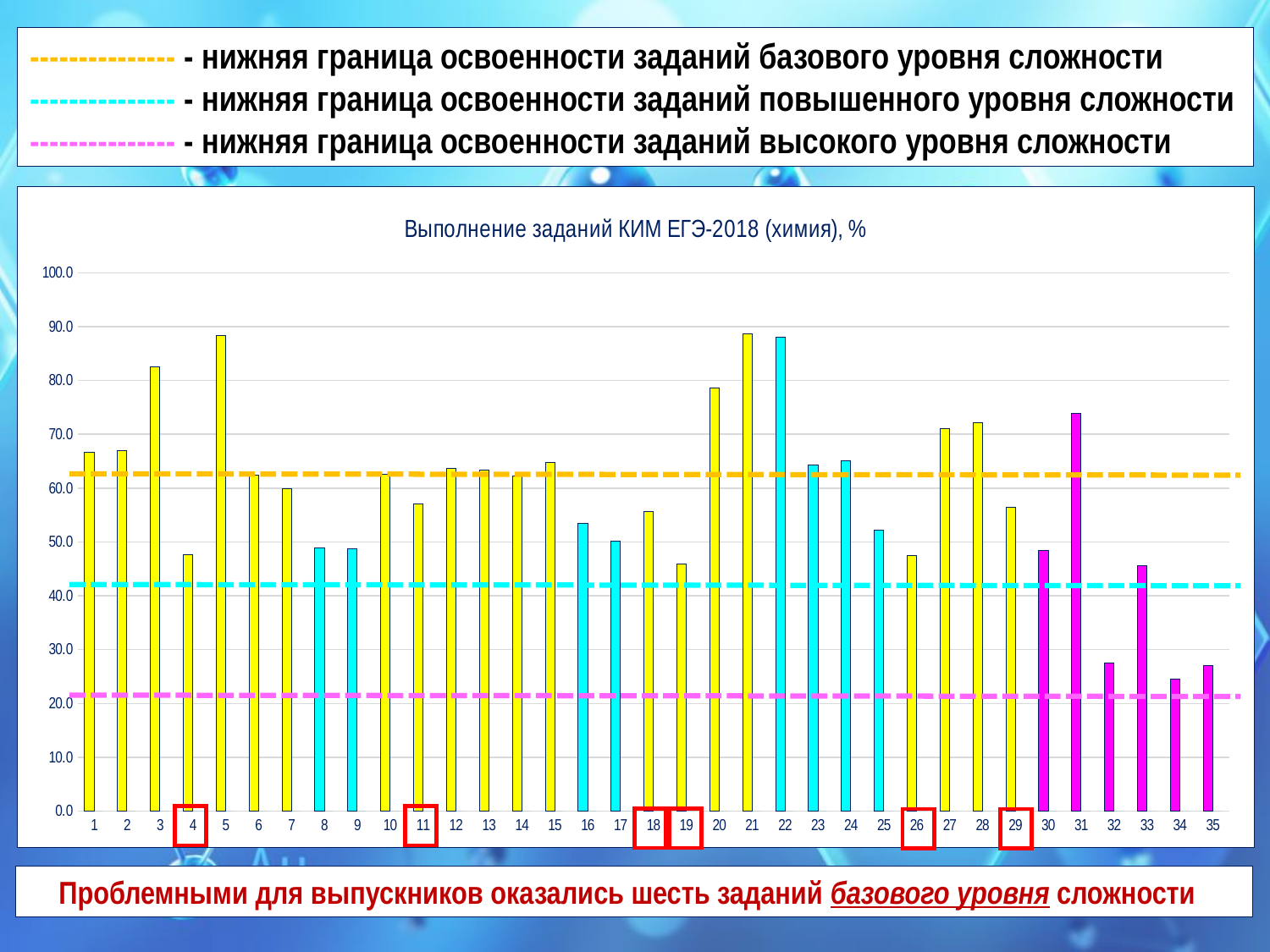
Is the value for task 34 greater or less than 20? greater Is the value for task 4 greater or less than 50? less What is the title of the chart? Выполнение заданий КИМ ЕГЭ-2018 (химия), % Is the value for task 19 greater or less than 50? less How many task categories are plotted along the x axis? 35 Which has the higher value, task 31 or task 32? task 31 How many horizontal dashed threshold lines are drawn across the chart? 3 Which has the higher value, task 3 or task 4? task 3 What kind of chart is shown on the slide? bar chart